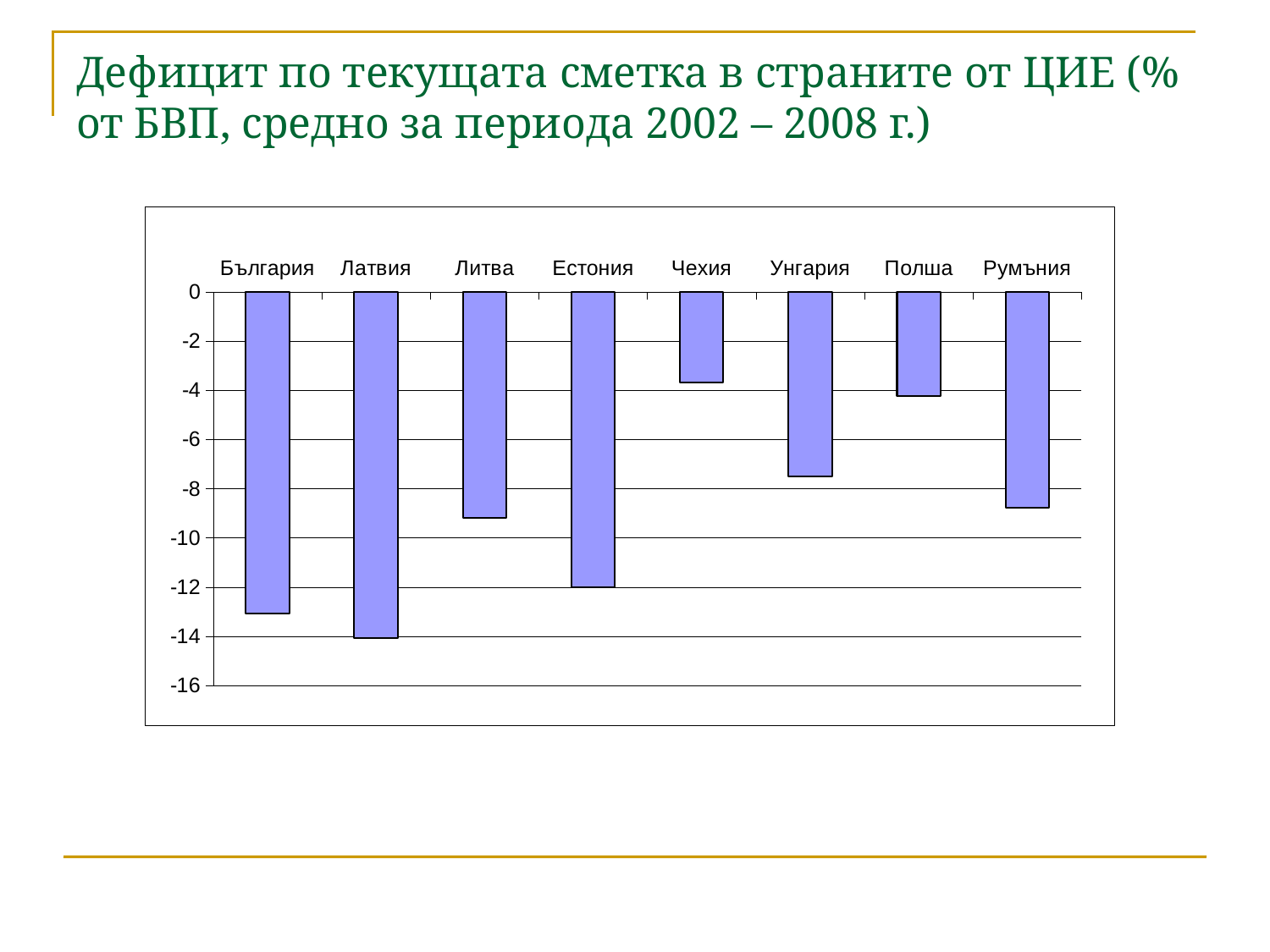
Which country has the larger deficit, Чехия or Полша? Полша Which country has the bar extending furthest below zero (the largest deficit)? Латвия Which country has the larger deficit, България or Естония? България Is the value for Чехия greater or less than -4? greater What period does the chart title say the averages cover? 2002 – 2008 г. Is the value for България greater or less than -12? less Is the value for Унгария greater or less than -8? greater Which bar extends further below zero, Литва or Унгария? Литва What kind of chart is shown on the slide? bar chart How many countries are shown on the chart? 8 Which country has the shortest bar (the smallest deficit)? Чехия